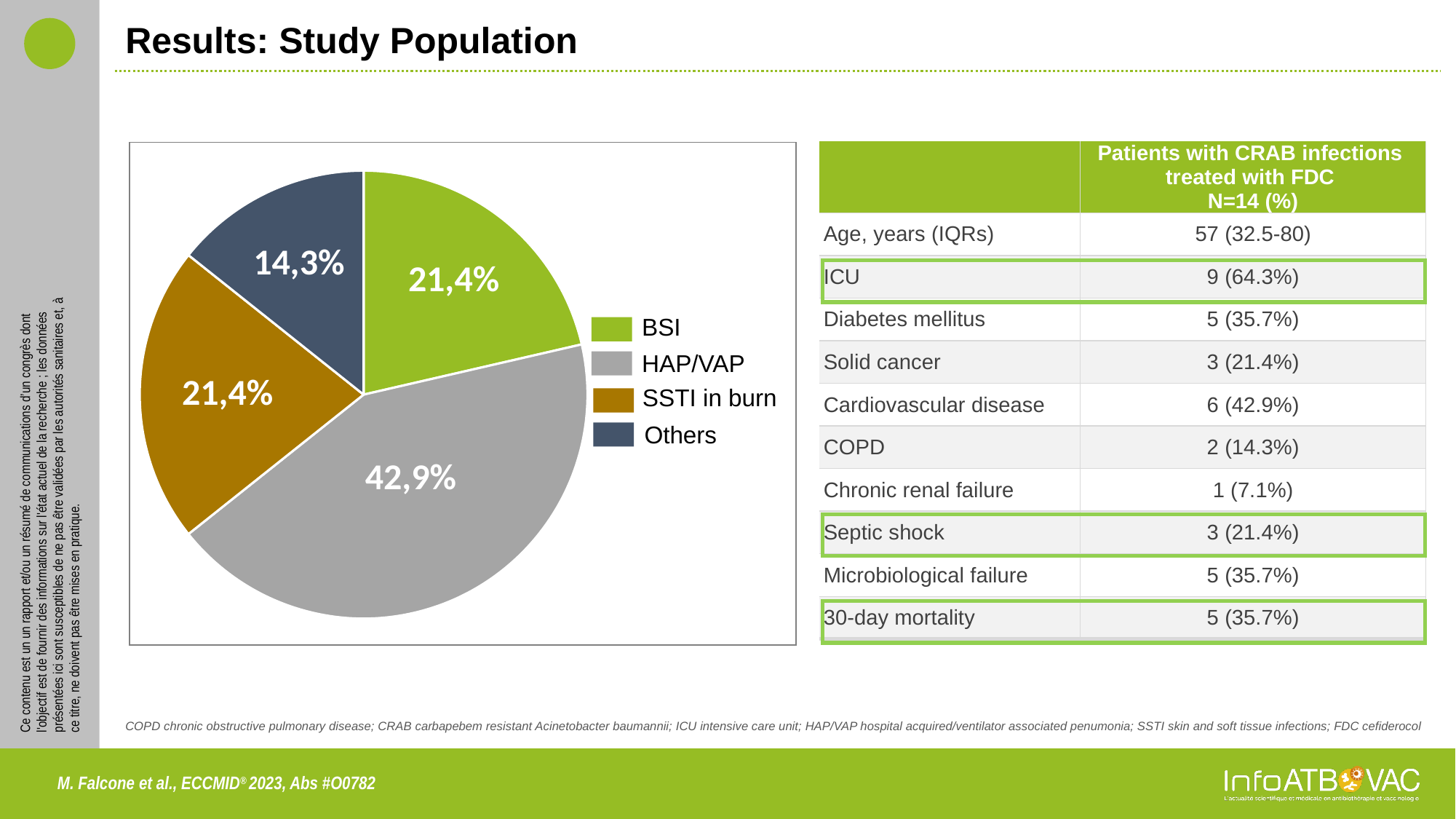
What share of the pie does BSI represent? 21,4% What colour is the HAP/VAP slice in the pie chart? grey What is the difference in percentage points between the HAP/VAP slice and the Others slice? 28,6 Which category has the largest slice of the pie? HAP/VAP How many categories does the pie chart show? 4 Which category has the smallest slice of the pie? Others What share of the pie does Others represent? 14,3% What share of the pie does HAP/VAP represent? 42,9% What kind of chart is shown on the slide? pie chart Which legend entry is shown in green? BSI Which is larger, the HAP/VAP slice or the BSI slice? HAP/VAP